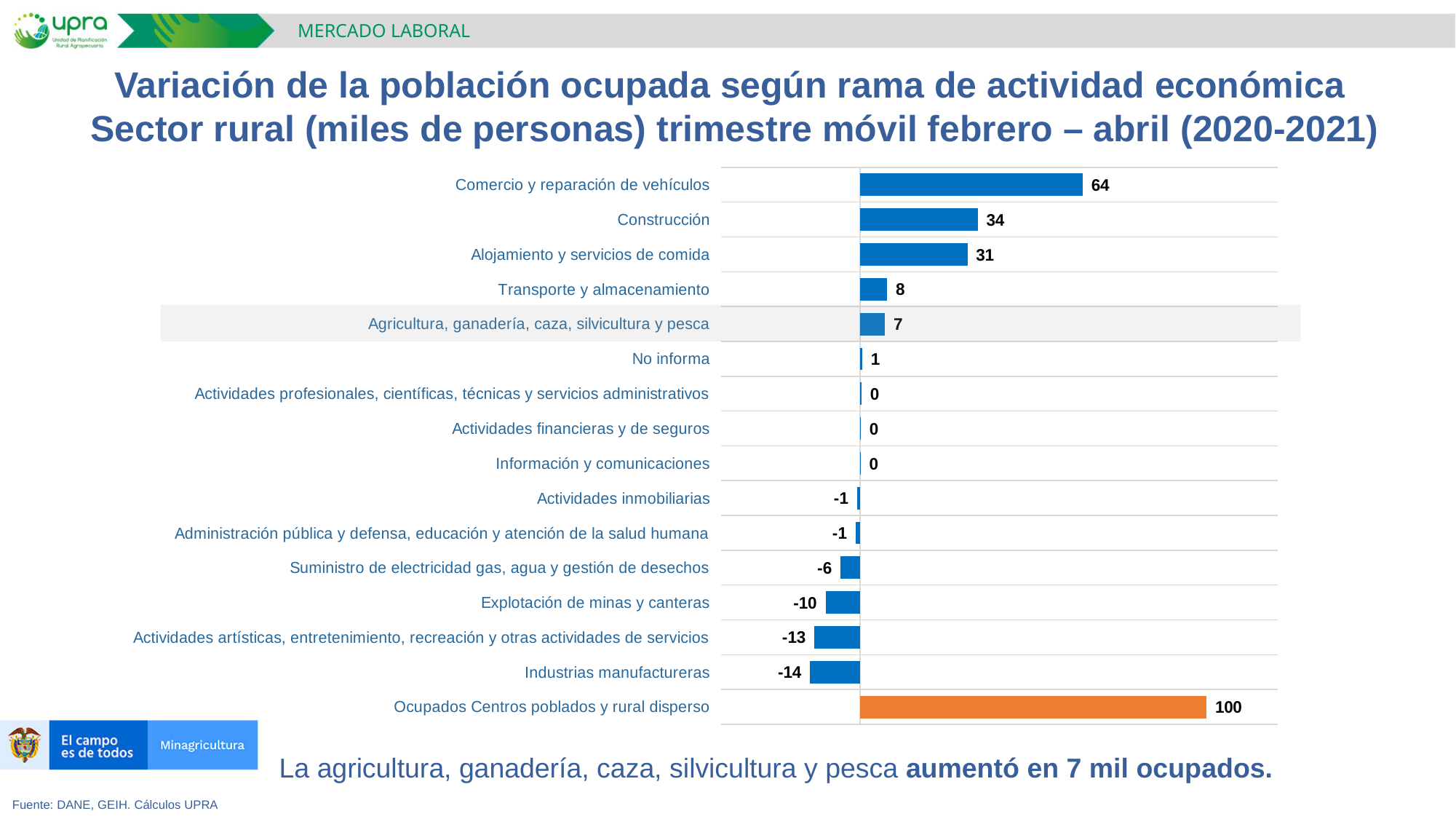
Which bar is shown in orange rather than blue? Ocupados Centros poblados y rural disperso What is the value for Industrias manufactureras? -14 How many categories are shown in the chart? 16 What is the difference between the values for Comercio y reparación de vehículos and Construcción? 30 Which category has the highest value? Ocupados Centros poblados y rural disperso What is the value for Construcción? 34 What is the value for Comercio y reparación de vehículos? 64 What is the value for Explotación de minas y canteras? -10 What is the value for Agricultura, ganadería, caza, silvicultura y pesca? 7 Which category has the lowest value? Industrias manufactureras Which is larger, the value for Alojamiento y servicios de comida or the value for Transporte y almacenamiento? Alojamiento y servicios de comida What kind of chart is shown on the slide? Bar chart